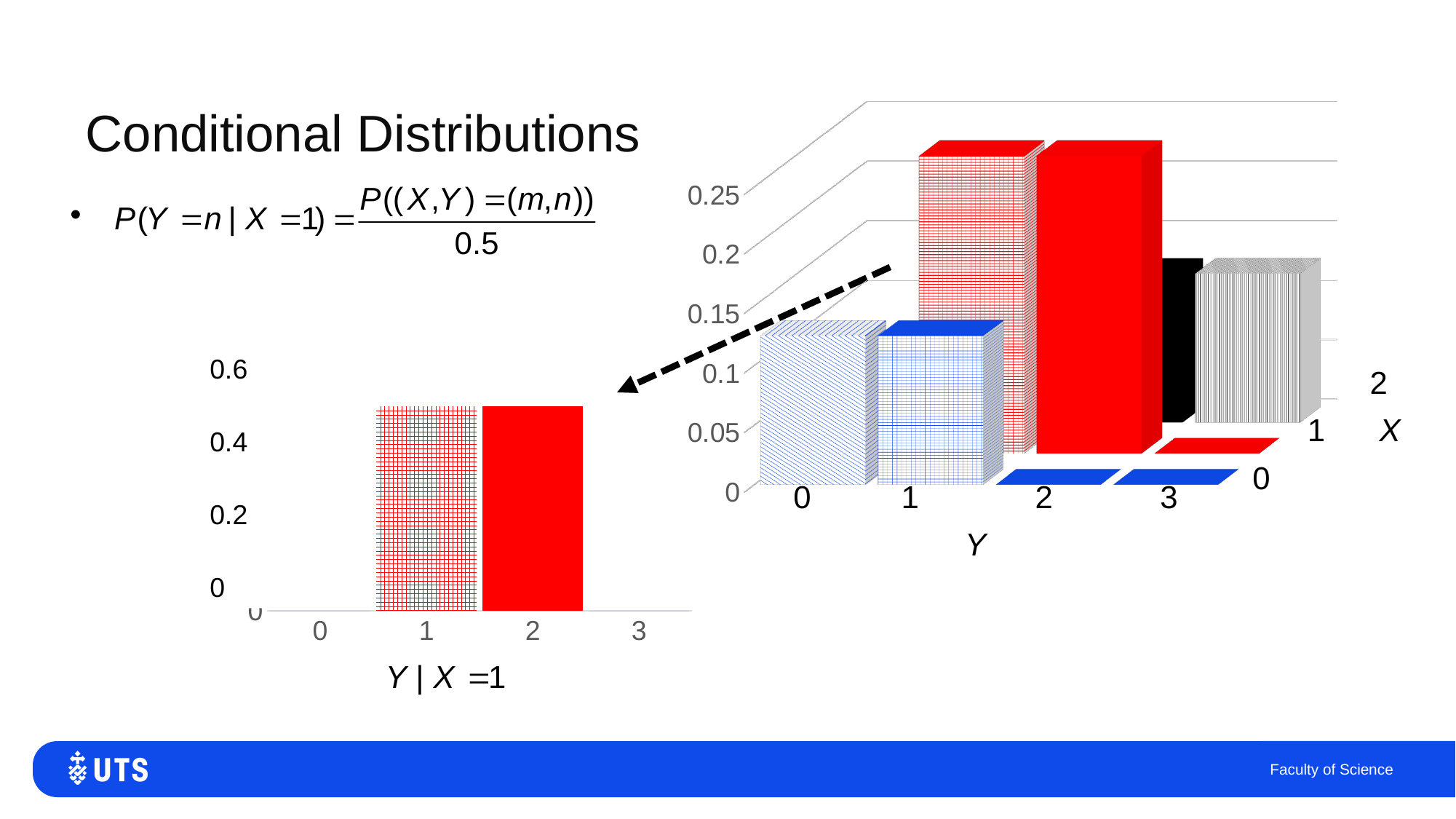
In the left chart (Y | X = 1), how many categories are shown on the x axis? 4 In the right chart, how many X values are shown on the depth axis? 3 In the right chart, is the value for Y = 2 at X = 1 greater or less than 0.2? greater In the right chart, how many Y categories are shown along the horizontal axis? 4 In the left chart (Y | X = 1), is the value for category 1 greater or less than 0.4? greater What is the x-axis title of the left chart? Y | X = 1 In the right chart, which is larger: the bar for Y = 2 at X = 1 or the bar for Y = 0 at X = 0? Y = 2 at X = 1 What kind of chart is the left chart (Y | X = 1)? bar chart In the left chart (Y | X = 1), is the value for category 2 greater or less than 0.6? less What kind of chart is the right chart? 3D bar chart In the right chart, what is the highest tick label on the vertical axis? 0.25